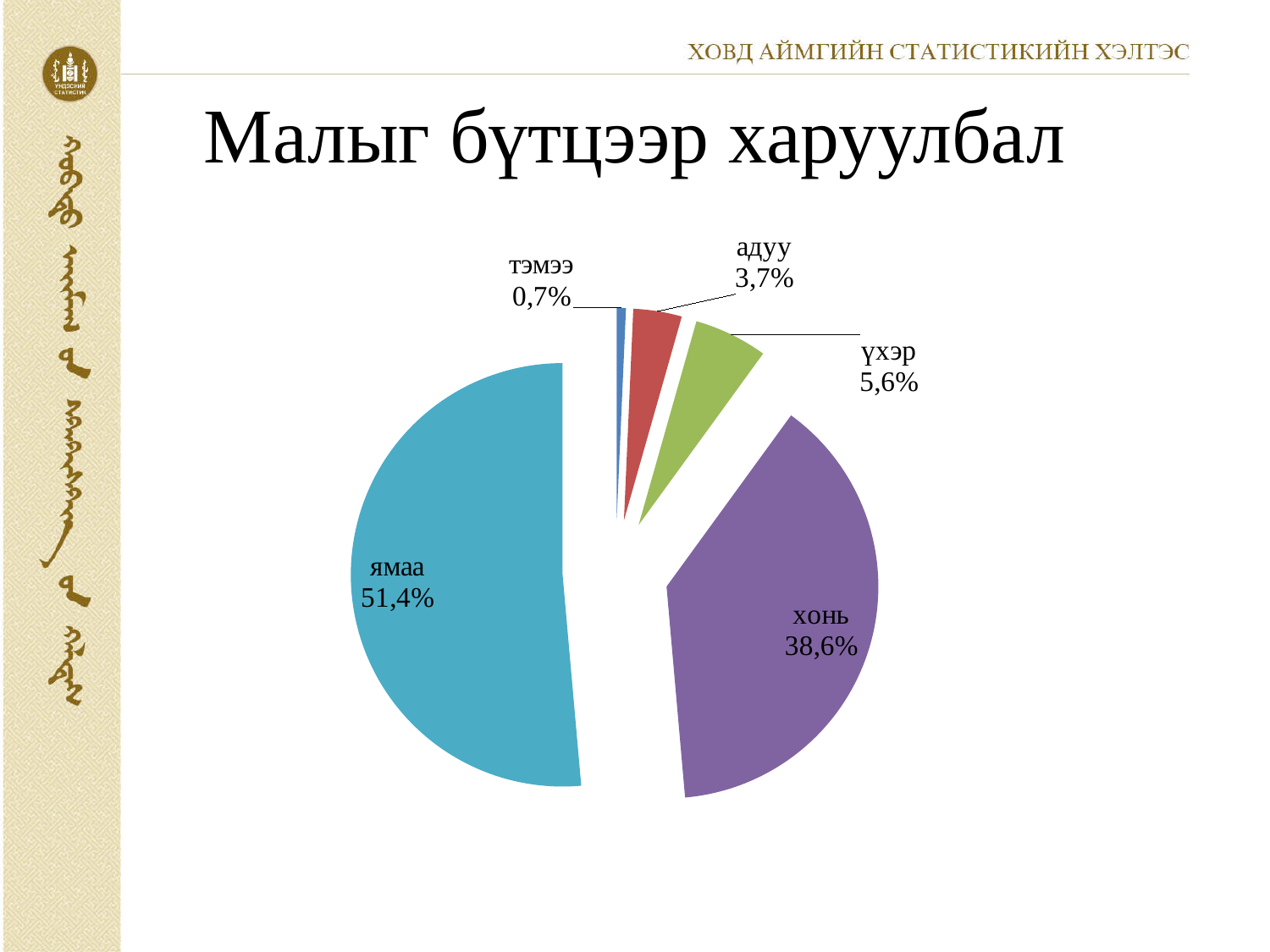
Which is larger, the share for үхэр or the share for адуу? үхэр What share of the pie does хонь have? 38,6% What share of the pie does ямаа have? 51,4% What is the value shown for тэмээ? 0,7% What is the difference between the shares of ямаа and хонь? 12,8% Which category has the smallest slice of the pie? тэмээ What is the title of the chart on the slide? Малыг бүтцээр харуулбал What is the value shown for үхэр? 5,6% What is the value shown for адуу? 3,7% Which category has the largest slice of the pie? ямаа How many slices does the pie chart have? 5 What kind of chart is shown on the slide? pie chart